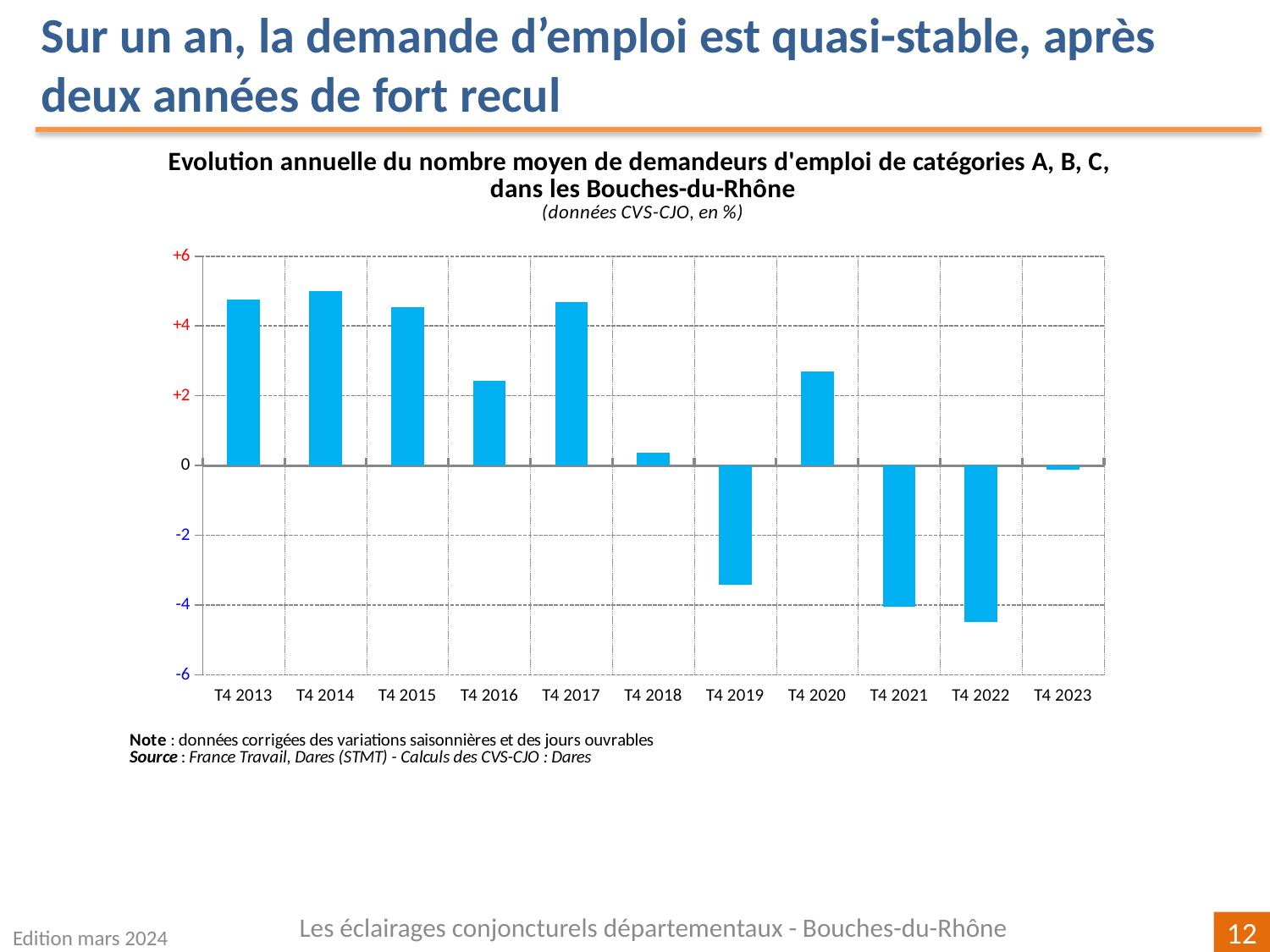
Which is larger, the value for T4 2016 or the value for T4 2017? T4 2017 Is the value for T4 2014 greater or less than +4? greater How many quarters (categories) are plotted on the x axis? 11 What kind of chart is shown on the slide? bar chart Do the values rise or fall from T4 2017 to T4 2019? fall Is the value for T4 2022 greater or less than -4? less What is the title of the chart? Evolution annuelle du nombre moyen de demandeurs d'emploi de catégories A, B, C, dans les Bouches-du-Rhône Is the value for T4 2020 greater or less than +2? greater Which is larger, the value for T4 2018 or the value for T4 2020? T4 2020 Which quarter has the lowest value? T4 2022